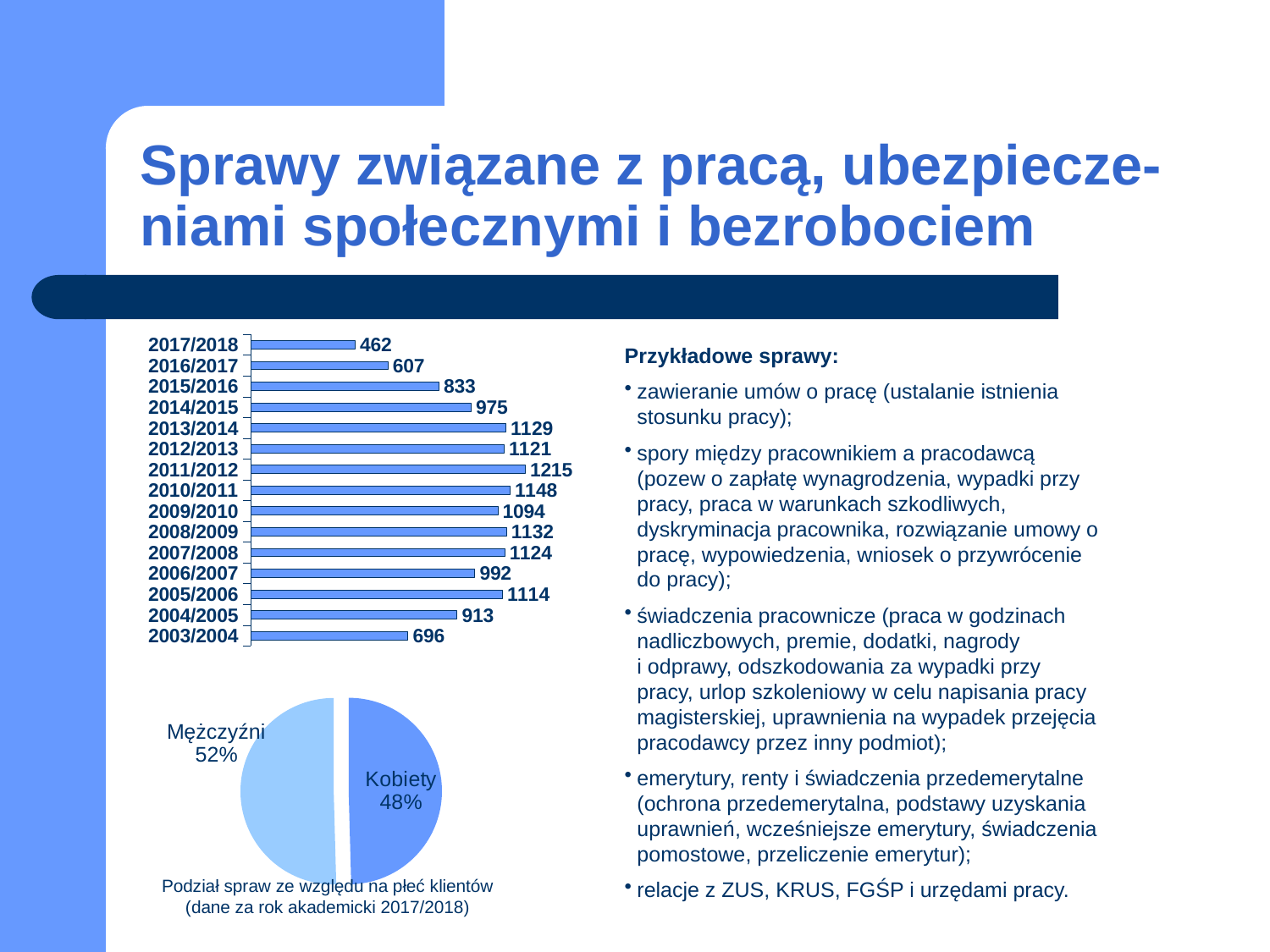
In the pie chart, what share is labelled Mężczyźni? 52% In the bar chart, what is the value for 2011/2012? 1215 In the bar chart, which academic year has the highest value? 2011/2012 In the bar chart, which is larger: the value for 2015/2016 or the value for 2014/2015? 2014/2015 What kind of chart is the chart at the top left of the slide? bar chart How many academic years are shown in the bar chart? 15 In the pie chart, what share is labelled Kobiety? 48% In the bar chart, what is the difference between the values for 2003/2004 and 2004/2005? 217 In the bar chart, what is the value for 2006/2007? 992 What is the caption below the pie chart? Podział spraw ze względu na płeć klientów (dane za rok akademicki 2017/2018) In the bar chart, which academic year has the lowest value? 2017/2018 In the bar chart, what is the value for 2017/2018? 462